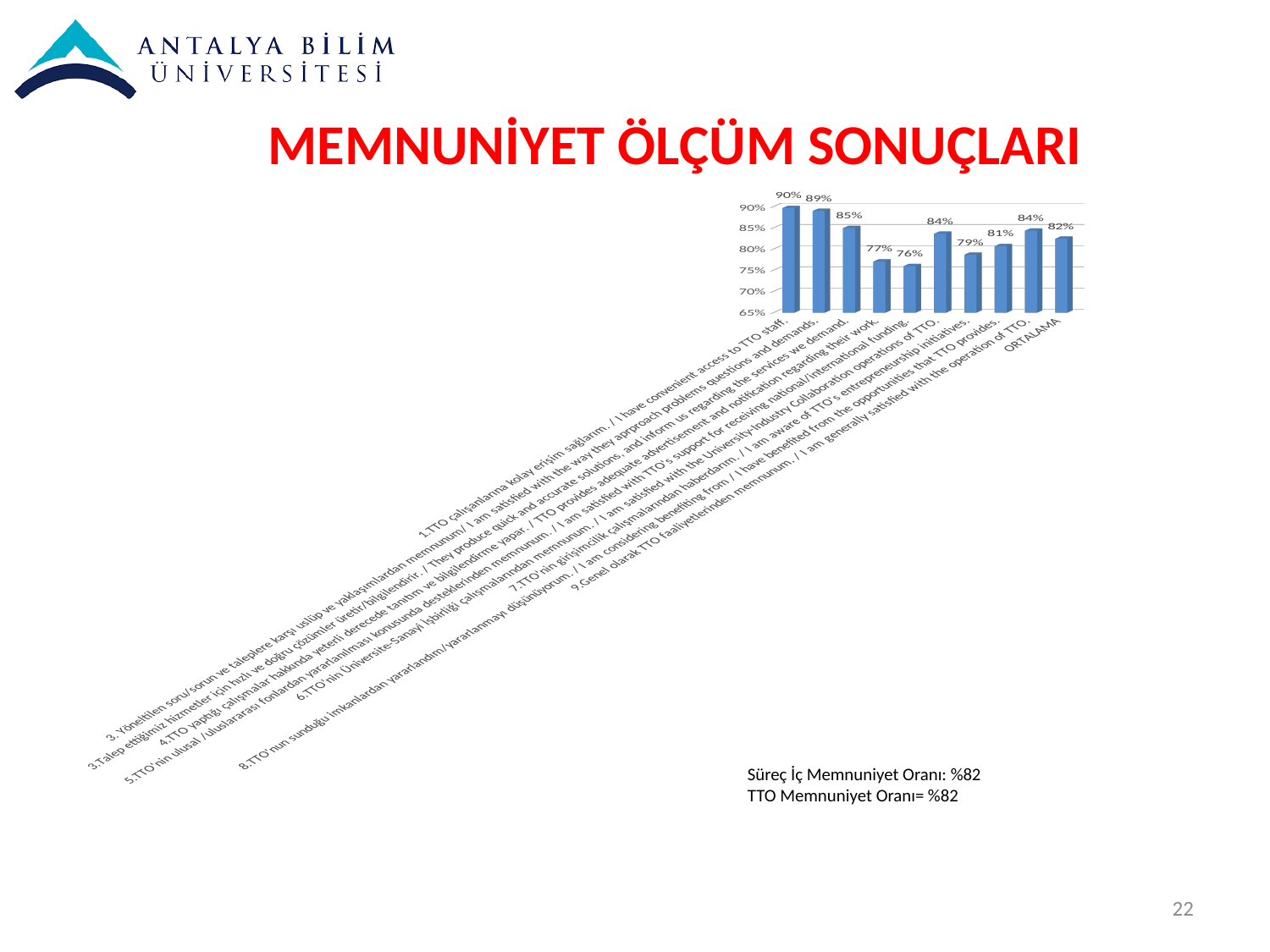
What is the value of the first bar (item 1, about easy access to TTO staff)? 90% What is the highest value shown in the chart? 90% What is the lowest value shown in the chart? 76% What is the value of the ORTALAMA bar? 82% Which is larger: the value of the second bar (item 2) or the value of the third bar (item 3)? the second bar (89%) How many bars are plotted in the chart? 10 What kind of chart is shown on the slide? bar chart Is the value of the seventh bar (item 7) greater or less than 80%? less What is the value of the fifth bar (item 5, about benefiting from national/international funding)? 76% What is the title of the slide containing the chart? MEMNUNİYET ÖLÇÜM SONUÇLARI What is the difference between the highest value (90%) and the lowest value (76%) in the chart? 14% What is the difference between the ORTALAMA bar (82%) and the fourth bar (77%)? 5%